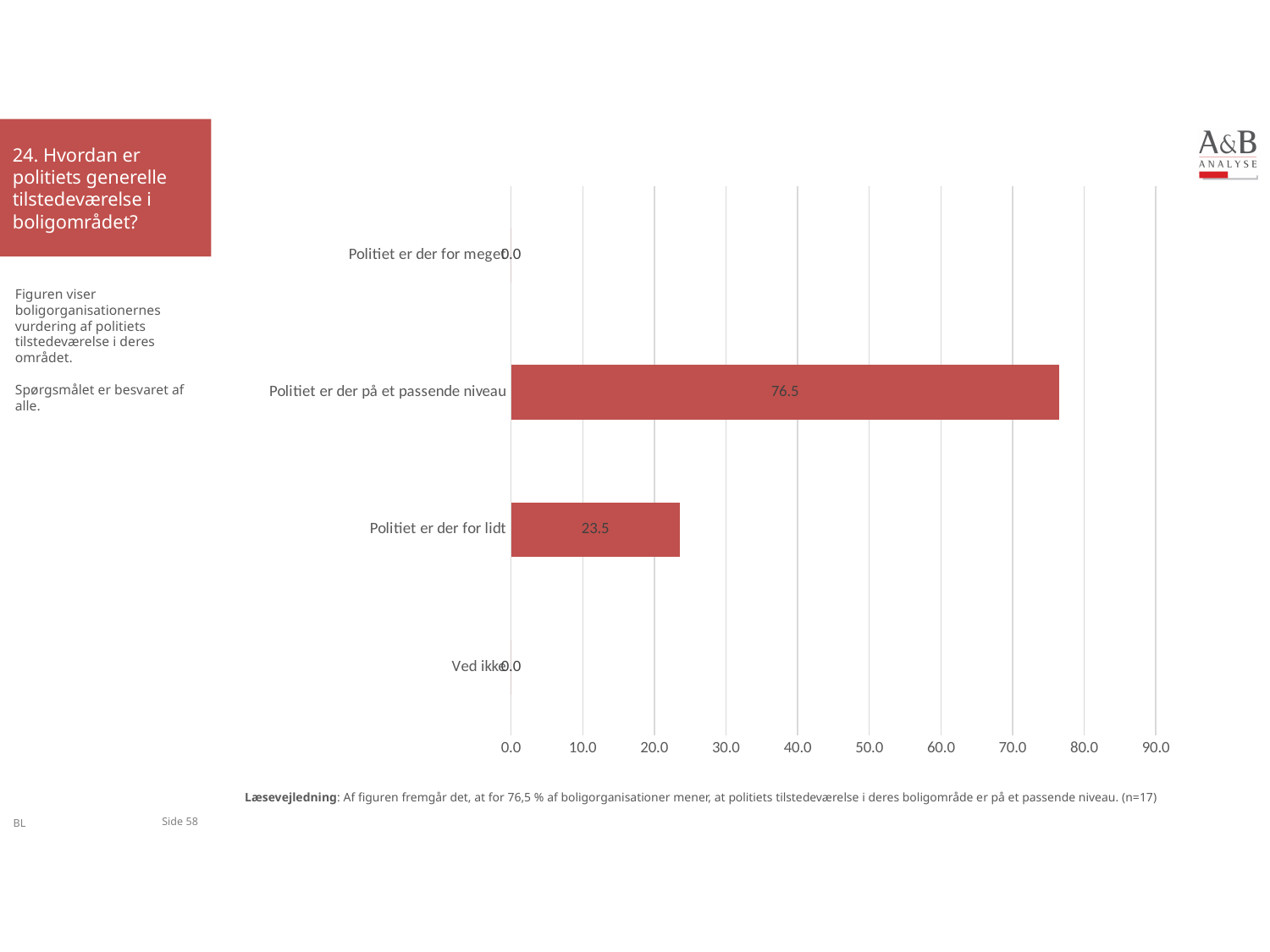
How many categories are shown in the chart? 4 What is the difference between the values for "Politiet er der på et passende niveau" and "Politiet er der for lidt"? 53.0 Is the value for "Politiet er der for lidt" greater or less than 30.0? less Is the value for "Politiet er der på et passende niveau" greater or less than 70.0? greater What kind of chart is shown on the slide? Bar chart What is the highest value shown on the x axis? 90.0 What is the value for "Ved ikke"? 0.0 Which category has the highest value? Politiet er der på et passende niveau Which is larger: the value for "Politiet er der for lidt" or the value for "Politiet er der på et passende niveau"? Politiet er der på et passende niveau What is the value for "Politiet er der for meget"? 0.0 What is the value for "Politiet er der på et passende niveau"? 76.5 What is the value for "Politiet er der for lidt"? 23.5